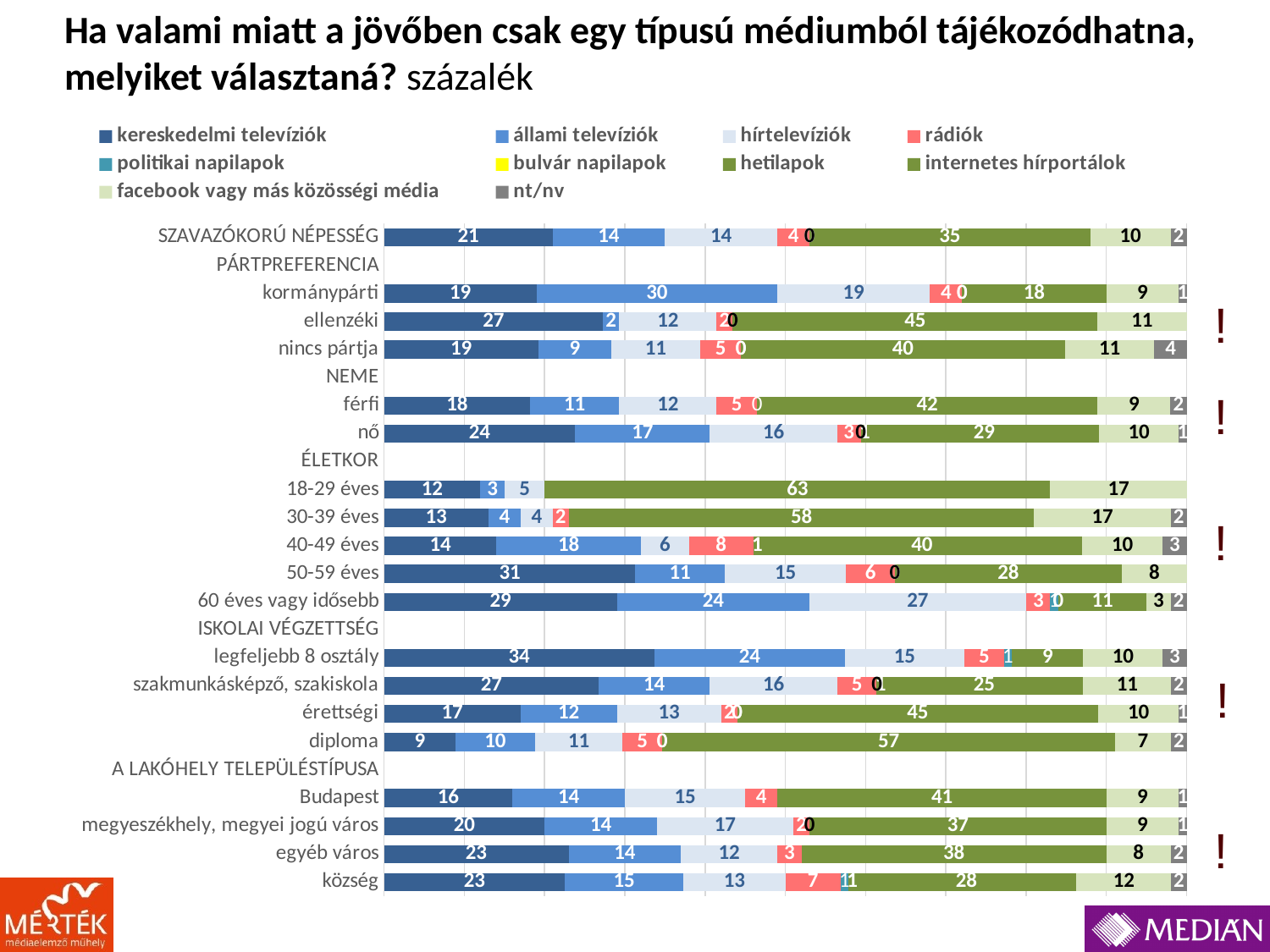
In the SZAVAZÓKORÚ NÉPESSÉG row, how much larger is the internetes hírportálok value than the kereskedelmi televíziók value? 14 What kind of chart is shown on the slide? stacked bar chart Among the party preference groups (PÁRTPREFERENCIA), which has the lowest value for internetes hírportálok? kormánypárti What is the value for kereskedelmi televíziók in the legfeljebb 8 osztály row? 34 How many series does the legend list? 10 What is the value for állami televíziók in the kormánypárti row? 30 What is the difference between the internetes hírportálok values for diploma and legfeljebb 8 osztály? 48 What is the value for internetes hírportálok in the 18-29 éves row? 63 Which legend entry is shown in yellow? bulvár napilapok Among the age groups (ÉLETKOR), which has the highest value for internetes hírportálok? 18-29 éves Which has a larger kereskedelmi televíziók value, férfi or nő? nő What is the value for facebook vagy más közösségi média in the 30-39 éves row? 17